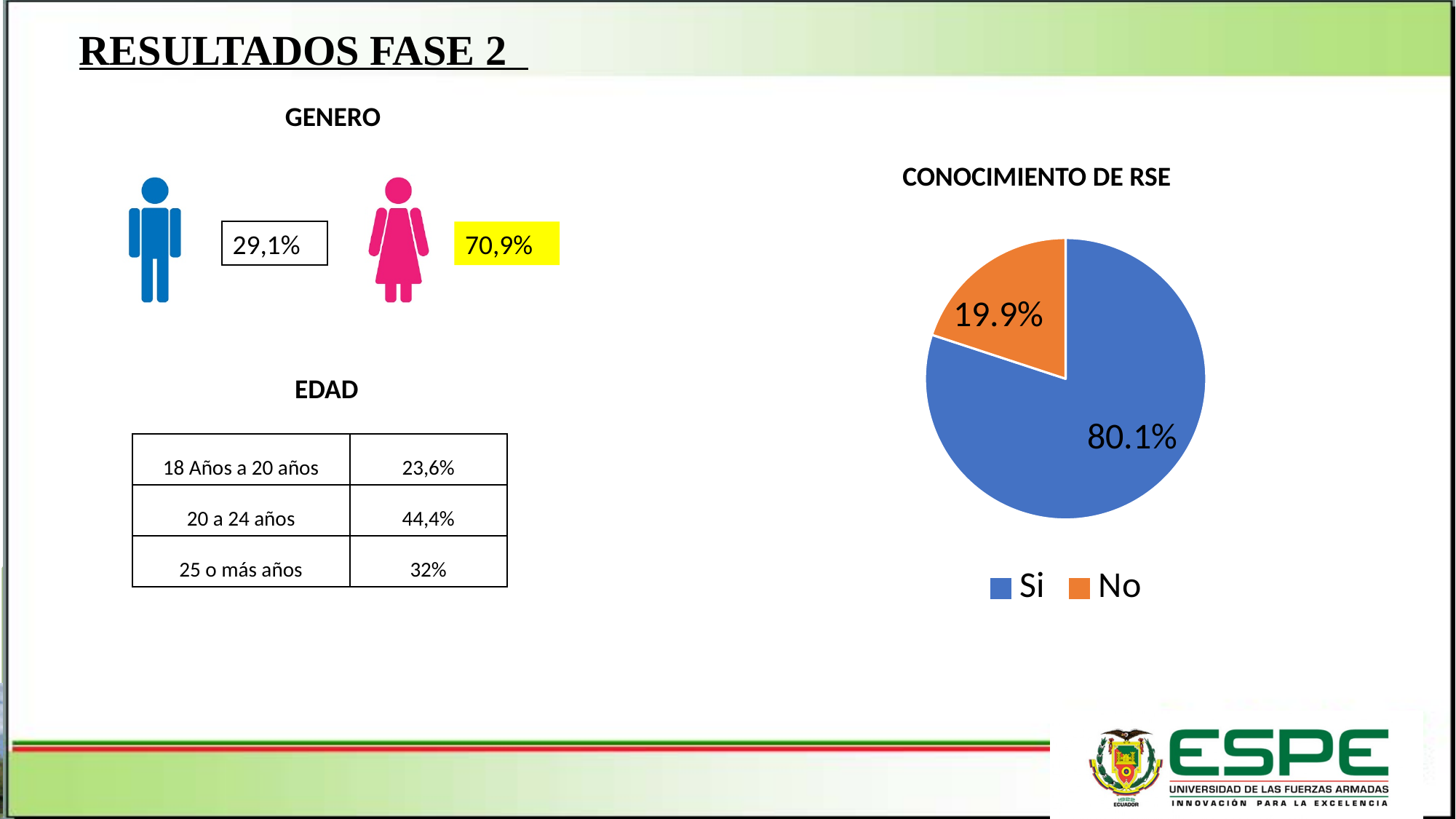
In the CONOCIMIENTO DE RSE chart, what colour is the Si slice? Blue In the CONOCIMIENTO DE RSE chart, what is the difference in percentage points between Si and No? 60.2 What is the title of the pie chart on the slide? CONOCIMIENTO DE RSE What kind of chart is CONOCIMIENTO DE RSE? Pie chart In the CONOCIMIENTO DE RSE chart, which category has the smallest slice? No In the CONOCIMIENTO DE RSE chart, what share of the pie does the No slice represent? 19.9% In the CONOCIMIENTO DE RSE chart, which category has the largest slice? Si In the CONOCIMIENTO DE RSE chart, what percentage corresponds to Si? 80.1% How many slices does the CONOCIMIENTO DE RSE pie chart have? 2 How many entries does the legend of the CONOCIMIENTO DE RSE chart list? 2 In the CONOCIMIENTO DE RSE chart, which is larger, Si or No? Si In the CONOCIMIENTO DE RSE chart, what percentage corresponds to No? 19.9%